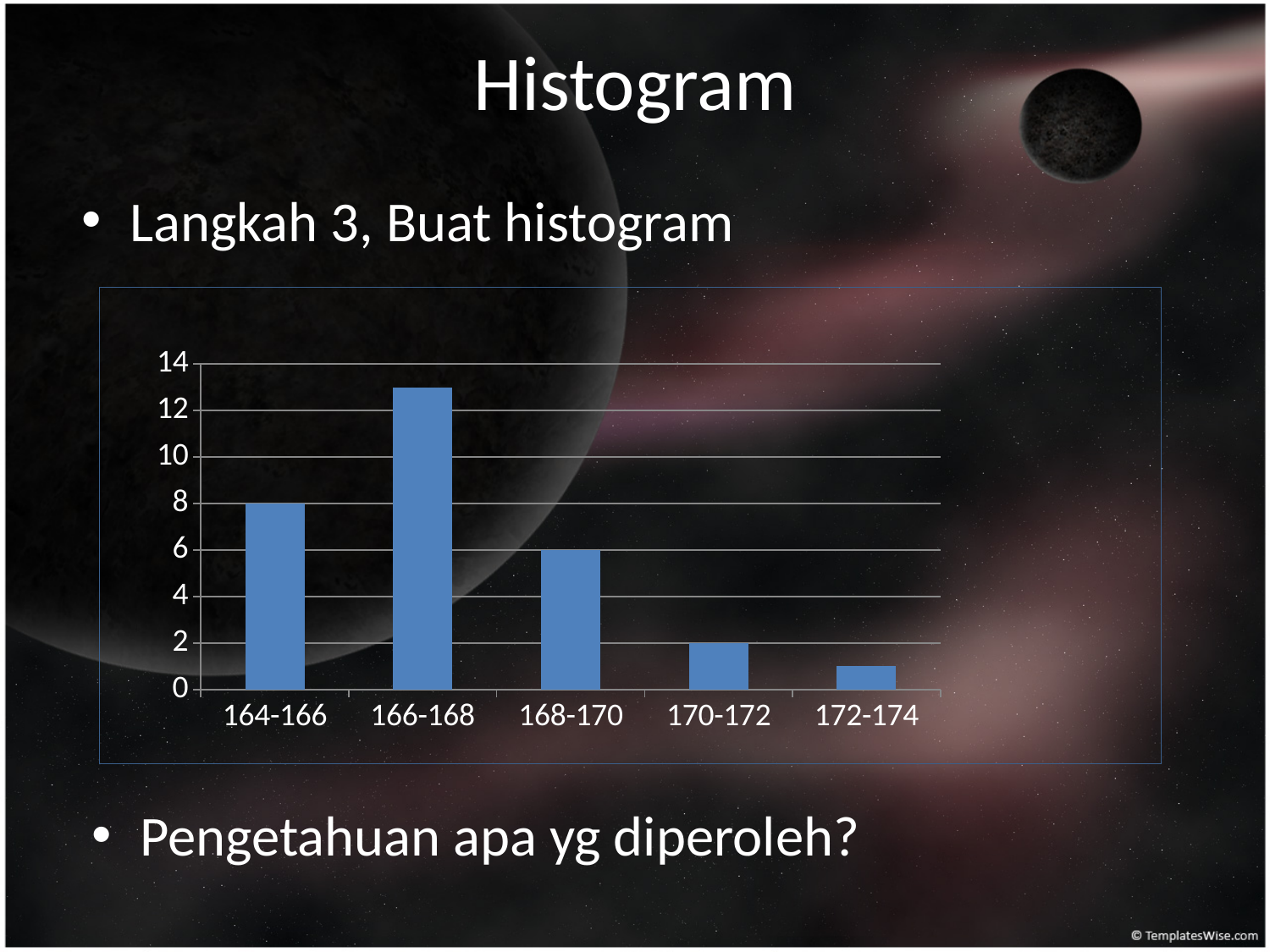
Do the values rise or fall along the x axis from 166-168 to 172-174? fall What is the difference between the values for 164-166 and 168-170? 2 Which is larger, the value for 164-166 or the value for 170-172? 164-166 Is the value for 172-174 greater or less than 2? less Is the value for 166-168 greater or less than 12? greater Which category has the highest bar in the chart? 166-168 What is the value for the 168-170 category? 6 Which category has the lowest bar in the chart? 172-174 What type of chart is shown on the slide? bar chart What is the value for the 170-172 category? 2 How many categories are shown on the x axis of the chart? 5 What is the value for the 164-166 category? 8